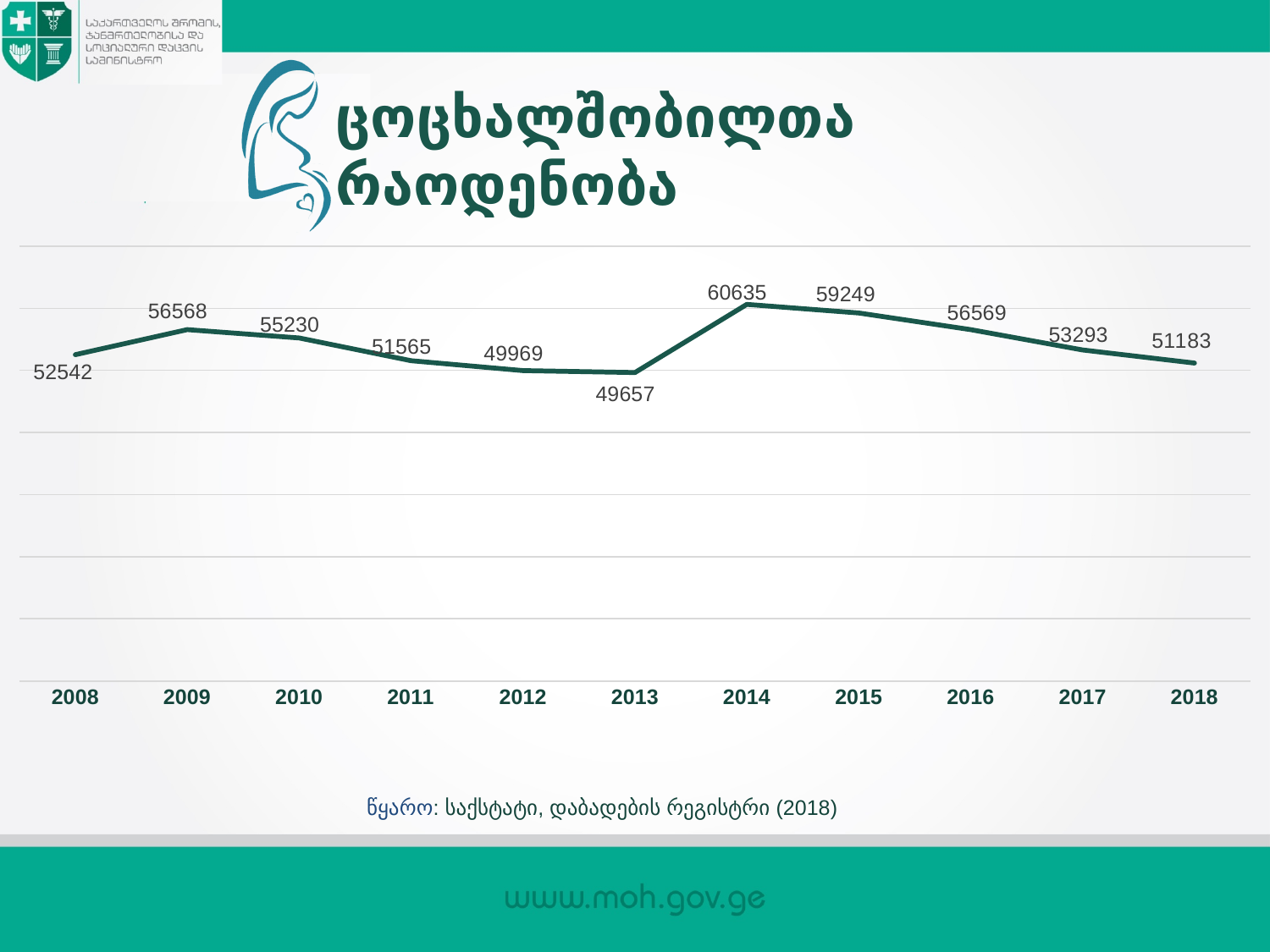
Do the values rise or fall from 2014 to 2018? fall What is the value for 2018? 51183 What is the value for 2008? 52542 How many years are shown on the x axis? 11 What kind of chart is shown on the slide? line chart What is the difference between the values for 2009 and 2008? 4026 Which year has the highest value? 2014 Which year has the lowest value? 2013 What is the value for 2014? 60635 What is the difference between the values for 2014 and 2013? 10978 Which is larger, the value for 2015 or the value for 2016? 2015 What is the value for 2013? 49657